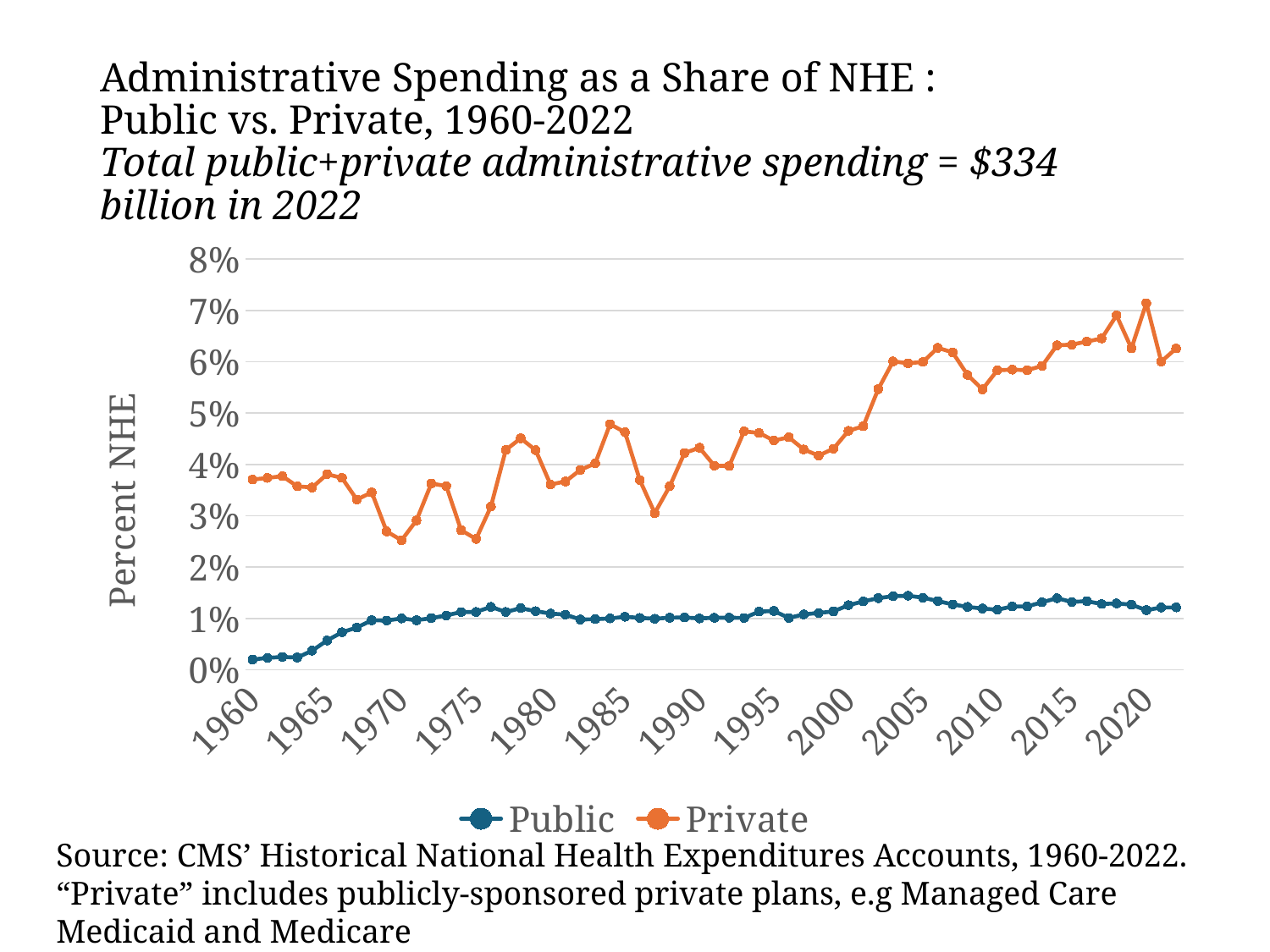
Which series is drawn in orange? Private Is the value for Private in 1970 greater or less than 3%? less Which series is higher in 2022, Public or Private? Private Does the Private series generally rise or fall between 2000 and 2020? rise Is the value for Public in 2005 greater or less than 1%? greater What kind of chart is shown on the slide? line chart What is the label on the y axis? Percent NHE Is the value for Public in 1960 greater or less than 1%? less How many series does the legend list? 2 Does the Public series rise or fall between 1960 and 1970? rise